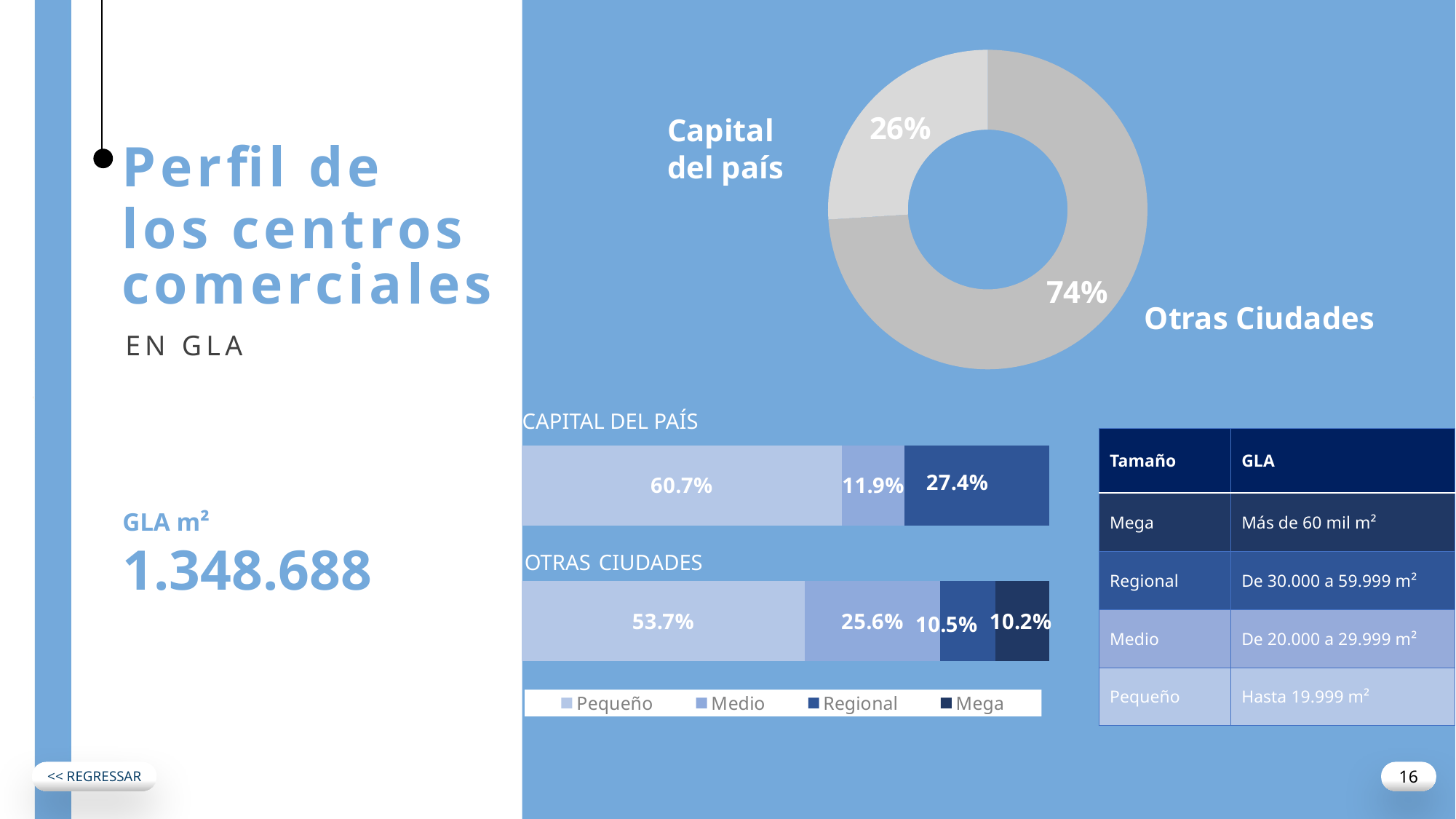
How many series does the legend of the stacked bar chart list? 4 What kind of chart is the one at the top showing Capital del país and Otras Ciudades? Donut (pie) chart In the stacked bar chart, is the Pequeño share larger for Capital del País or for Otras Ciudades? Capital del País In the donut chart at the top, what share does Capital del país have? 26% In the stacked bar chart, which segment is the largest in the Capital del País bar? Pequeño In the stacked bar chart, what is the Pequeño share for Capital del País? 60.7% In the donut chart at the top, what is the difference in percentage points between Otras Ciudades and Capital del país? 48 In the stacked bar chart, what is the Mega share for Otras Ciudades? 10.2% In the donut chart at the top, what share does Otras Ciudades have? 74% In the stacked bar chart, what is the difference between the Medio share of Otras Ciudades and that of Capital del País? 13.7 percentage points In the stacked bar chart, what is the Medio share for Otras Ciudades? 25.6% In the donut chart at the top, which category has the larger share? Otras Ciudades